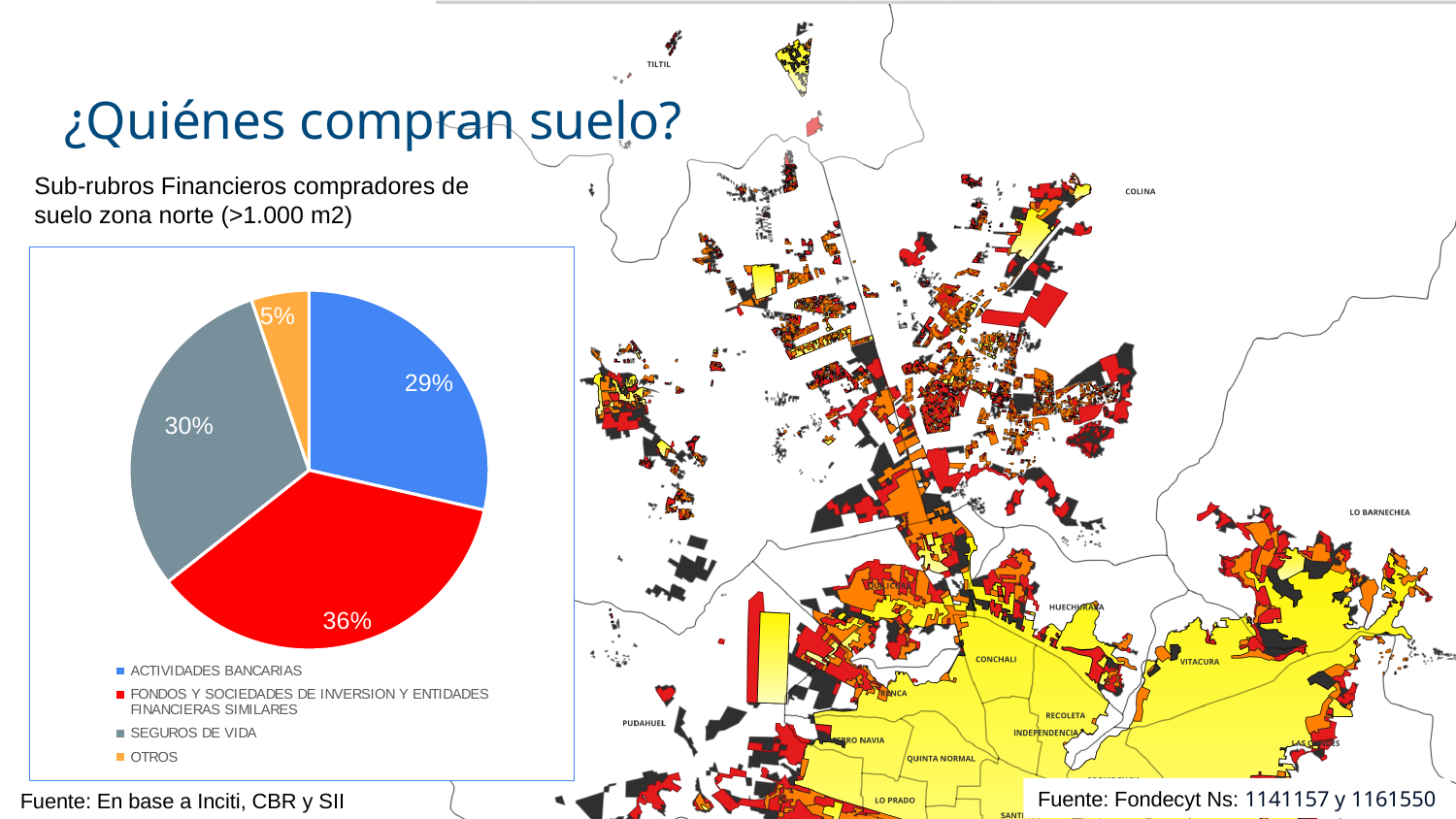
What share of the pie chart is FONDOS Y SOCIEDADES DE INVERSION Y ENTIDADES FINANCIERAS SIMILARES? 36% Which category has the largest slice of the pie chart? FONDOS Y SOCIEDADES DE INVERSION Y ENTIDADES FINANCIERAS SIMILARES What share of the pie chart is ACTIVIDADES BANCARIAS? 29% What colour is the SEGUROS DE VIDA slice in the pie chart? Grey What share of the pie chart is SEGUROS DE VIDA? 30% What is the difference in percentage points between the FONDOS Y SOCIEDADES DE INVERSION slice and the ACTIVIDADES BANCARIAS slice? 7 percentage points What share of the pie chart is OTROS? 5% How many categories does the pie chart show? 4 Which is larger in the pie chart: SEGUROS DE VIDA or ACTIVIDADES BANCARIAS? SEGUROS DE VIDA Which category has the smallest slice of the pie chart? OTROS What is the title of the pie chart? Sub-rubros Financieros compradores de suelo zona norte (>1.000 m2) What type of chart is shown on the left of the slide? Pie chart